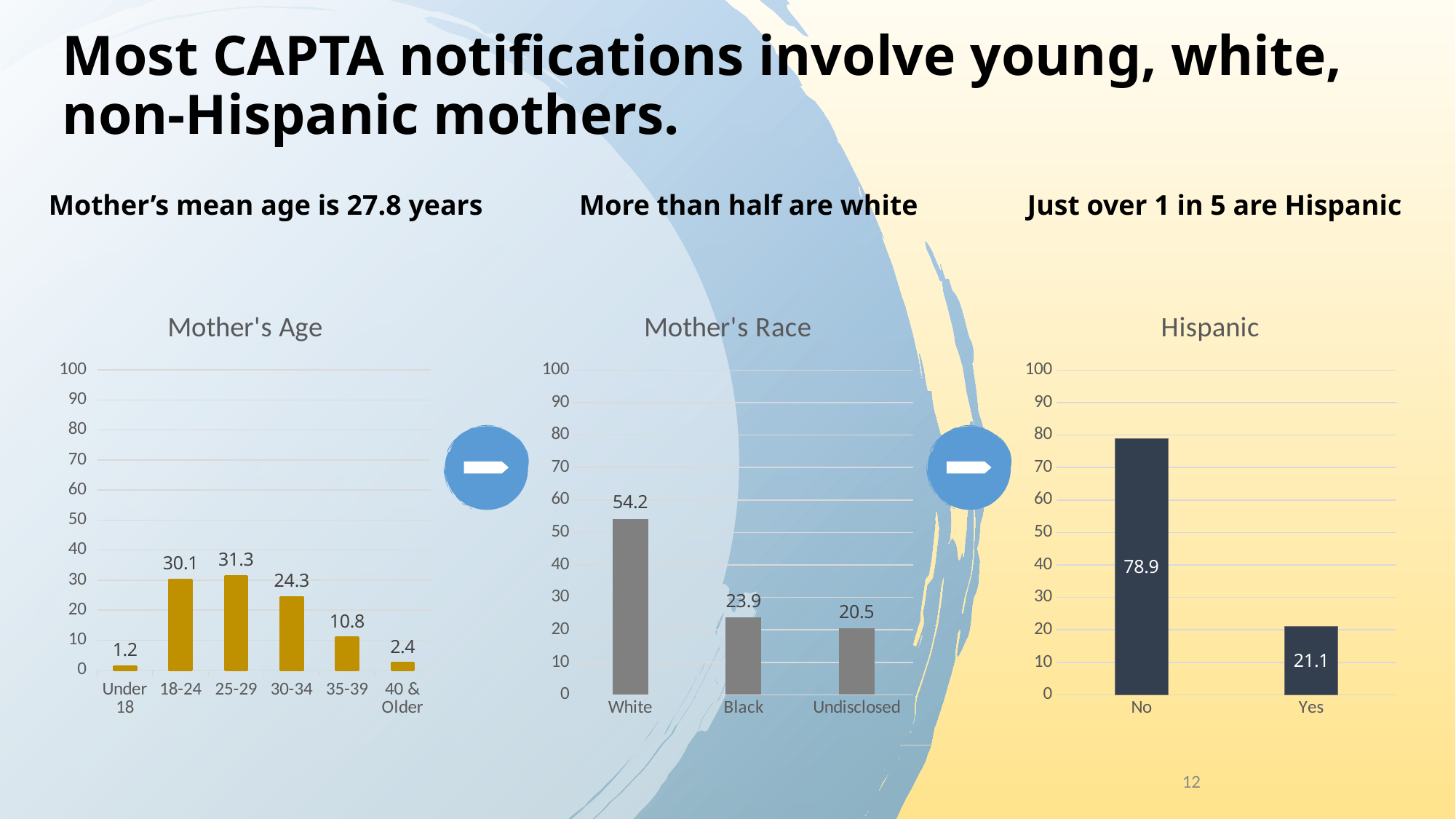
What is the title of the middle chart on the slide? Mother's Race In the Mother's Age chart, which age category has the lowest value? Under 18 In the Mother's Age chart, what is the difference between the 30-34 and 35-39 values? 13.5 In the Mother's Age chart, what is the value for the 25-29 category? 31.3 In the Mother's Age chart, how many age categories are shown? 6 In the Mother's Age chart, which age category has the highest value? 25-29 In the Mother's Race chart, what is the difference between the White and Undisclosed values? 33.7 What kind of chart is the Hispanic chart? Bar chart In the Mother's Race chart, what is the value for Black? 23.9 In the Mother's Race chart, which category has the highest value? White In the Hispanic chart, what is the value for Yes? 21.1 In the Hispanic chart, which is larger, No or Yes? No